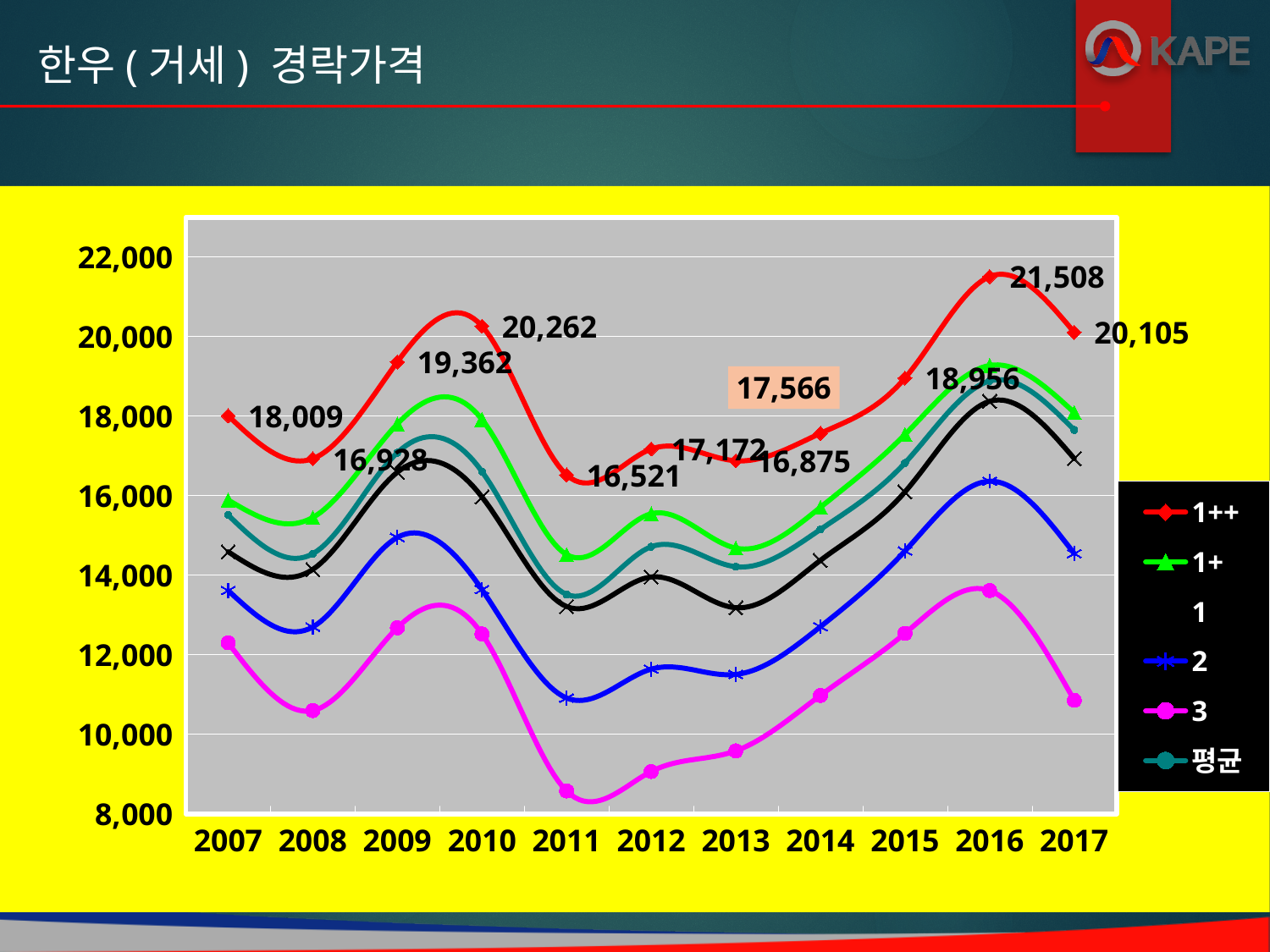
In which year does the 1++ series reach its lowest value? 2011 What kind of chart is shown on the slide? line chart How many series does the legend list? 6 Is the value of the 3 series in 2011 greater or less than 10,000? less In which year does the 1++ series reach its highest value? 2016 What is the value of the 1++ series in 2011? 16,521 What is the difference between the 1++ values in 2016 and 2017? 1,403 What is the value of the 1++ series in 2017? 20,105 What is the value of the 1++ series in 2007? 18,009 What is the value of the 1++ series in 2016? 21,508 How many years are shown on the x axis? 11 Which is larger for the 1++ series: the 2010 value or the 2009 value? 2010